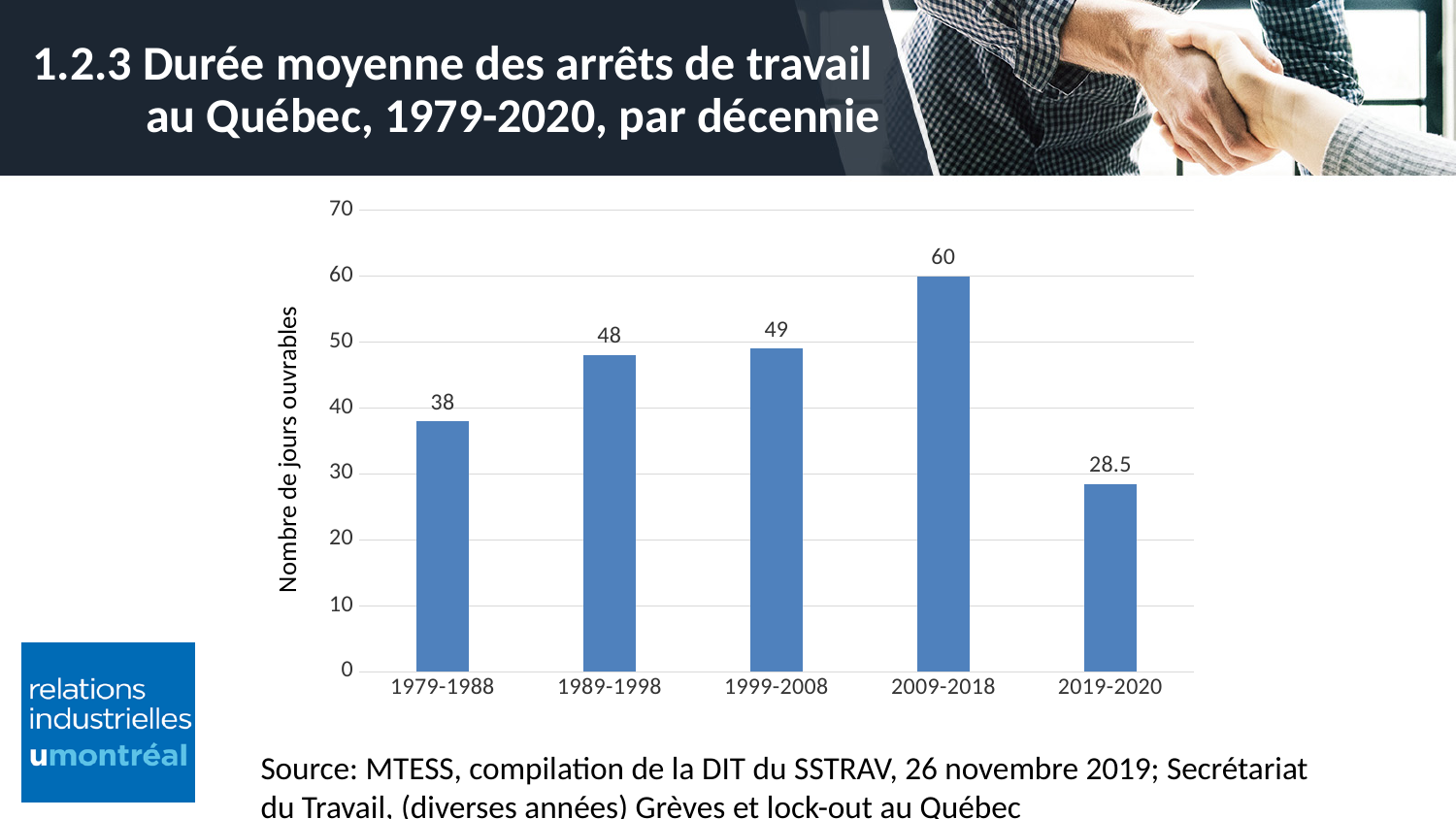
What kind of chart is shown on the slide? bar chart Which is larger, the value for 1989-1998 or the value for 2019-2020? 1989-1998 What is the value for 1979-1988? 38 Which period has the lowest value? 2019-2020 Is the value for 2009-2018 greater or less than 50? greater What is the label of the y axis? Nombre de jours ouvrables Which period has the highest value? 2009-2018 How many periods are shown on the x axis? 5 What is the value for 1999-2008? 49 What is the difference between the values for 2009-2018 and 1979-1988? 22 What is the value for 2019-2020? 28.5 Do the values rise or fall from 1979-1988 to 2009-2018? rise